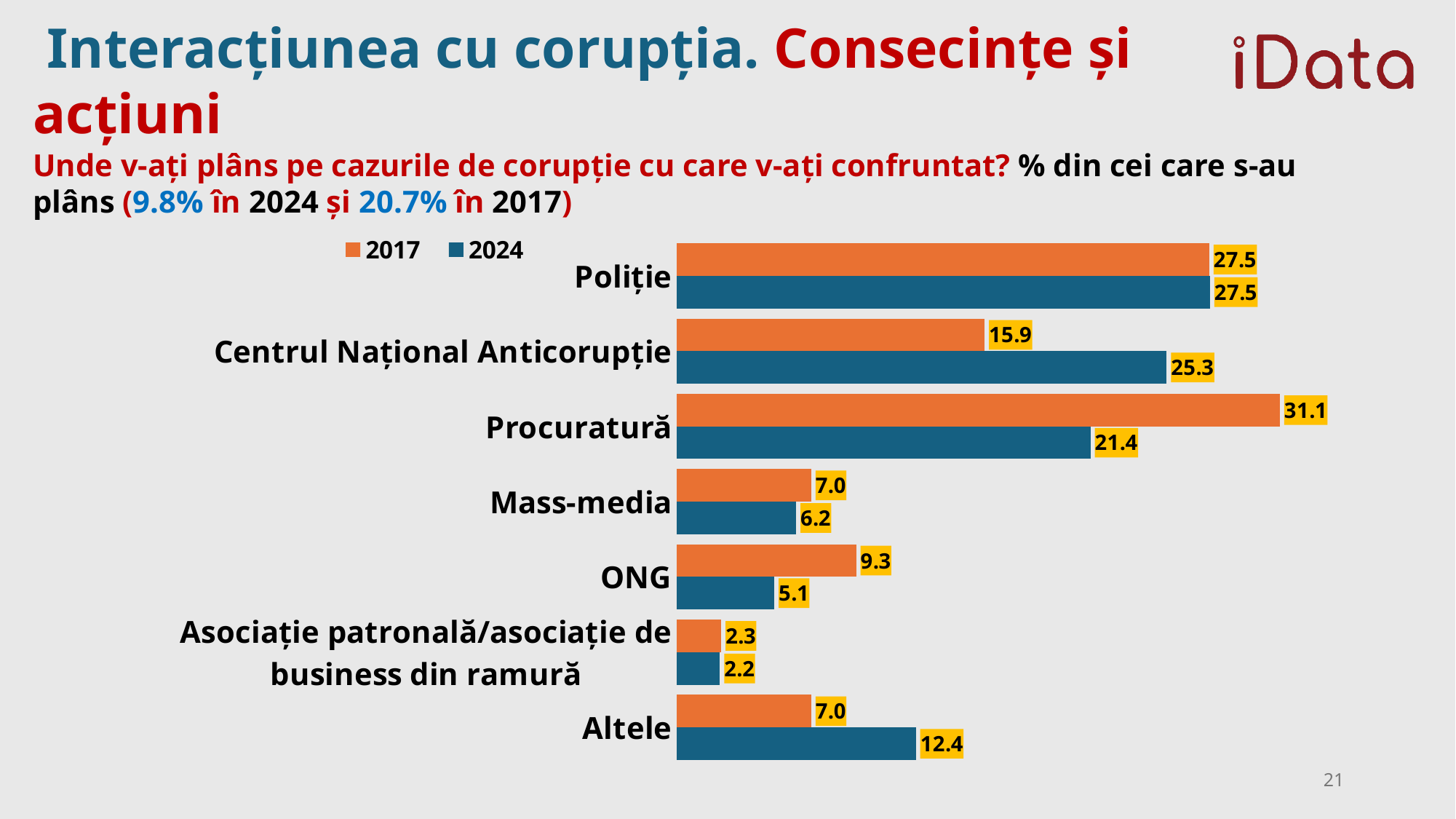
How many series does the legend list? 2 Which is larger for Altele: the 2017 value or the 2024 value? 2024 What is the difference between the 2017 and 2024 values for Procuratură? 9.7 How many categories are shown in the chart? 7 Which is larger for ONG: the 2017 value or the 2024 value? 2017 What kind of chart is shown on the slide? Bar chart What is the 2024 value for Centrul Național Anticorupție? 25.3 What is the difference between the 2024 and 2017 values for Centrul Național Anticorupție? 9.4 What is the 2024 value for Altele? 12.4 What is the 2017 value for Procuratură? 31.1 Which category has the lowest 2024 value? Asociație patronală/asociație de business din ramură Which category has the highest 2017 value? Procuratură